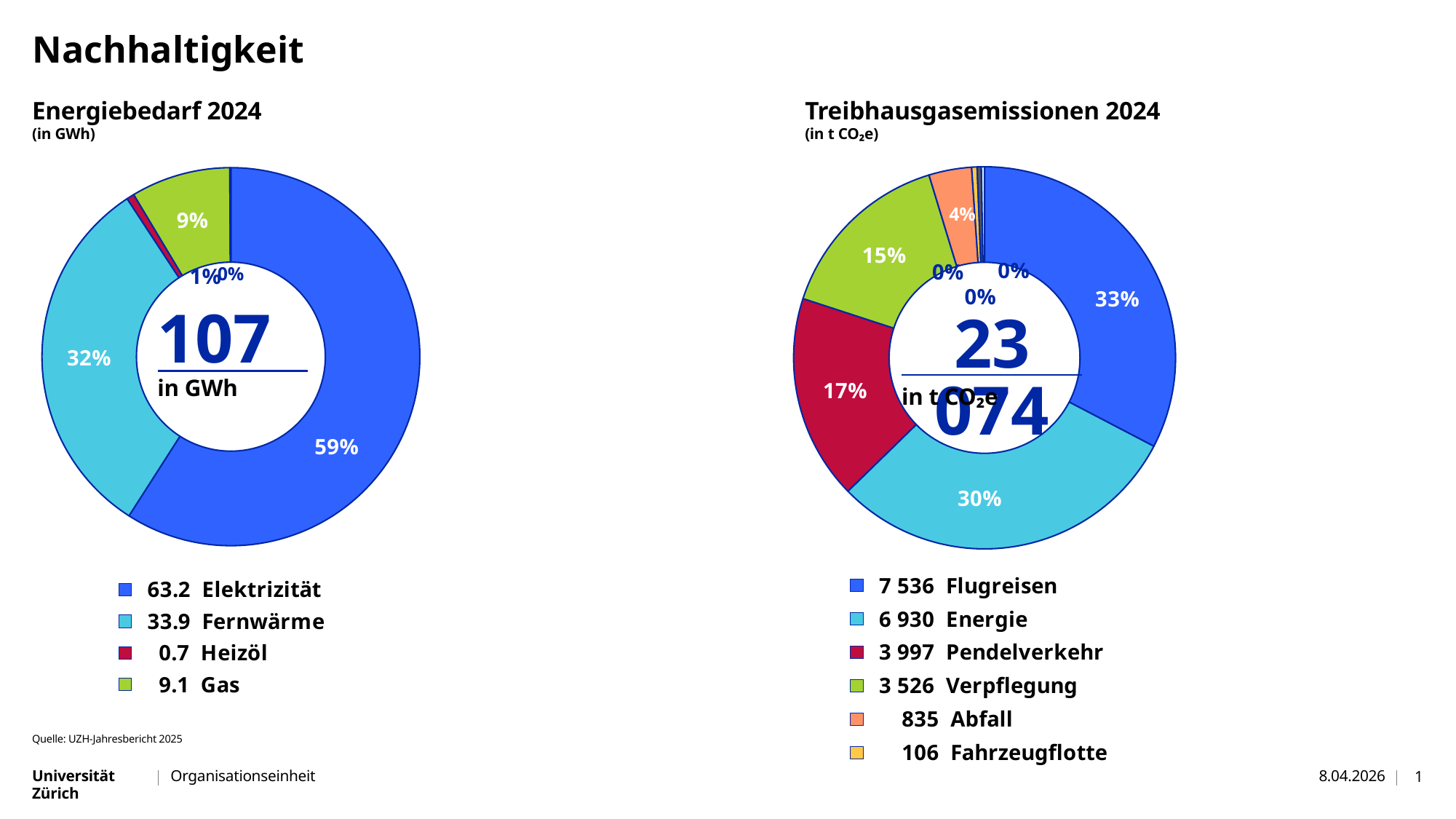
What total value is shown in the centre of the Energiebedarf 2024 chart? 107 In the Treibhausgasemissionen 2024 chart, what is the value for Pendelverkehr? 3 997 How many categories does the legend of the Energiebedarf 2024 chart list? 4 In the Treibhausgasemissionen 2024 chart, which is larger: Energie or Verpflegung? Energie In the Energiebedarf 2024 chart, what share of the total does Fernwärme account for? 32% In the Treibhausgasemissionen 2024 chart, what share of the total does Flugreisen account for? 33% In the Energiebedarf 2024 chart, which category has the largest value? Elektrizität In the Treibhausgasemissionen 2024 chart, what is the difference between the values for Flugreisen and Energie? 606 In the Energiebedarf 2024 chart, what is the value for Elektrizität? 63.2 What kind of chart is the Energiebedarf 2024 chart on the left? doughnut chart